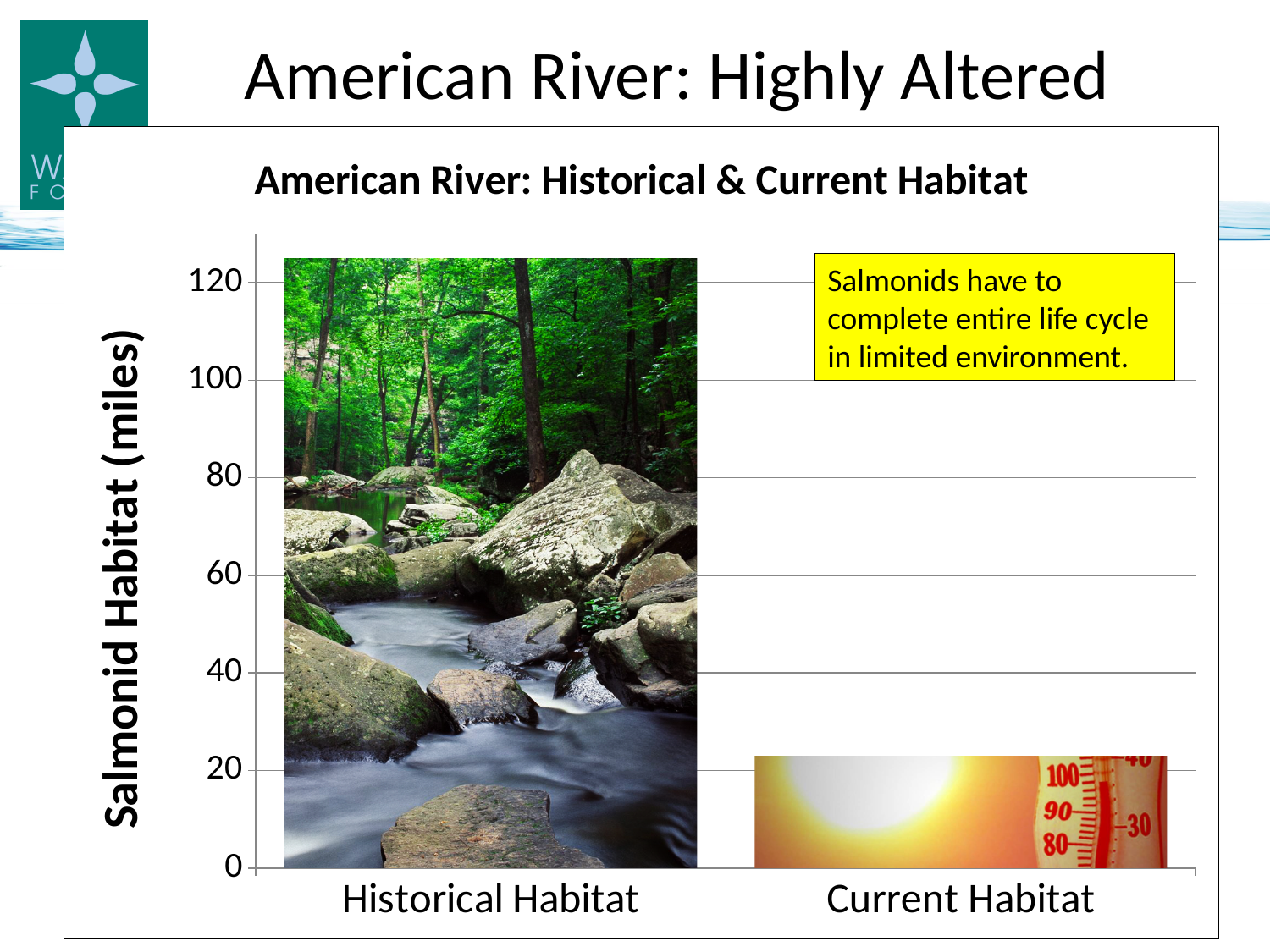
Is the value for Historical Habitat greater or less than 100? greater Which category has the highest salmonid habitat value? Historical Habitat What is the label on the y axis of the chart? Salmonid Habitat (miles) Do the values rise or fall from Historical Habitat to Current Habitat? fall Is the value for Current Habitat greater or less than 60? less What kind of chart is shown on the slide? bar chart Is the value for Current Habitat greater or less than 40? less Which is larger, the value for Historical Habitat or the value for Current Habitat? Historical Habitat Which category has the lowest salmonid habitat value? Current Habitat What is the title of the chart? American River: Historical & Current Habitat How many categories are plotted on the x axis? 2